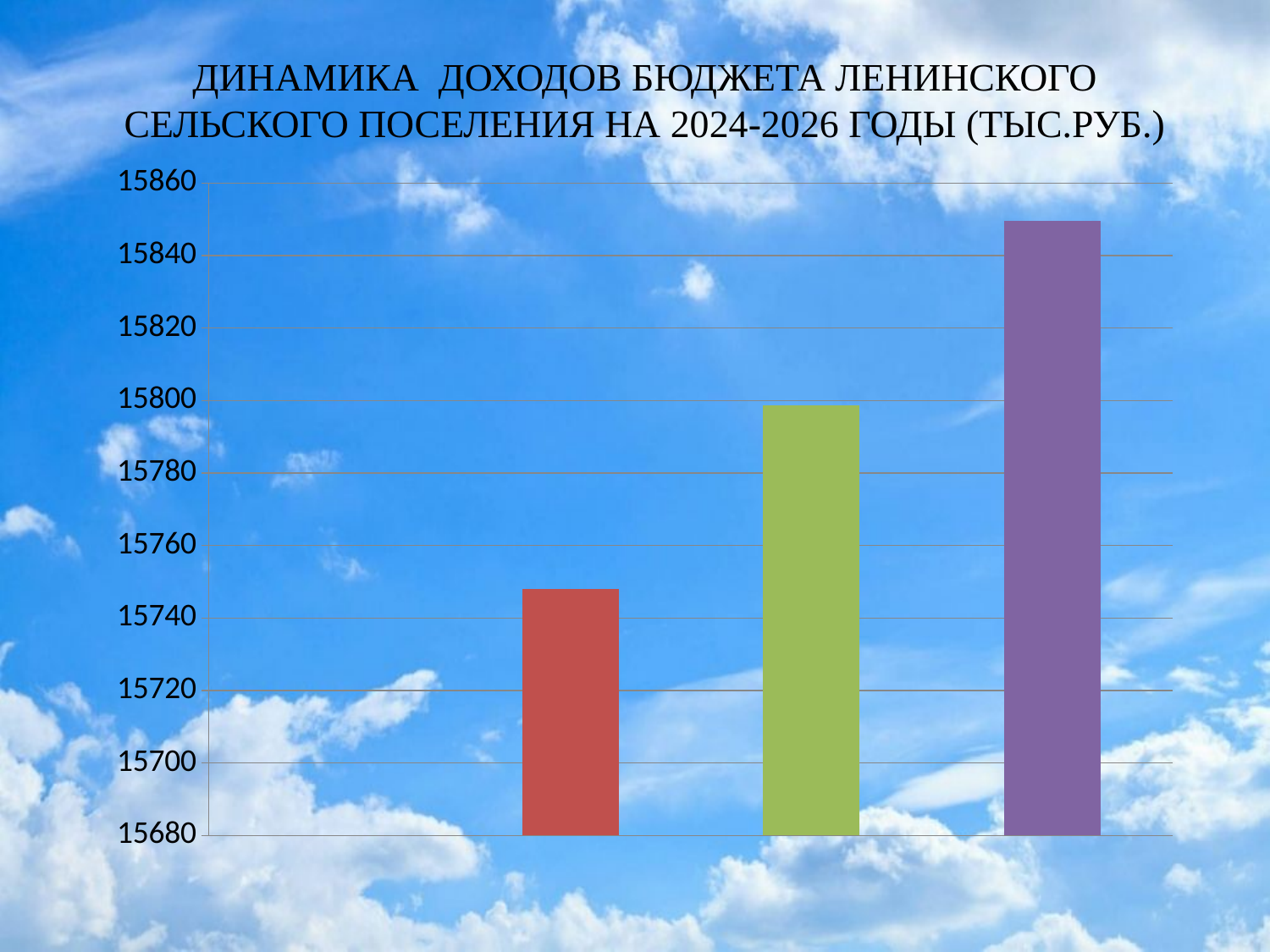
Is the value of the purple (rightmost) bar greater or less than 15840? greater How many bars are plotted in the chart? 3 What kind of chart is shown on the slide? bar chart Which bar is the tallest in the chart: the red, the green or the purple one? purple Is the value of the red (leftmost) bar greater or less than 15760? less Which is larger, the value of the green bar or the value of the red bar? green bar Is the value of the purple (rightmost) bar greater or less than 15860? less What unit of measurement is stated in the chart title? ТЫС.РУБ. Which bar is the shortest in the chart: the red, the green or the purple one? red Do the bar values rise or fall from left to right across the chart? rise